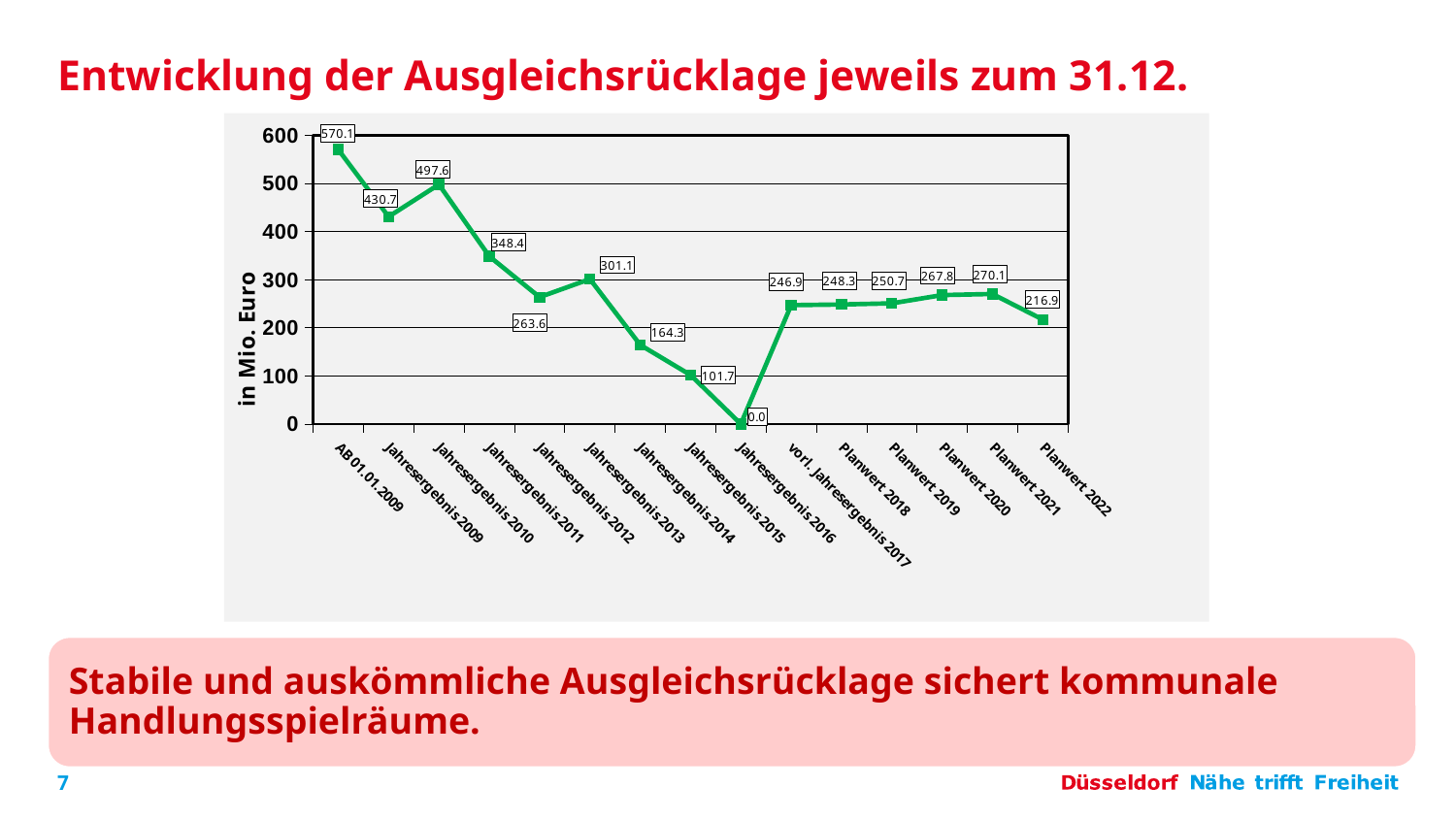
What is the value for Jahresergebnis 2011? 348.4 Which category has the highest value? AB 01.01.2009 What is the value for Planwert 2020? 267.8 What kind of chart is shown on the slide? Line chart Which is larger, the value for Jahresergebnis 2013 or the value for Jahresergebnis 2012? Jahresergebnis 2013 What is the difference between the values for Jahresergebnis 2010 and Jahresergebnis 2011? 149.2 What is the value for vorl. Jahresergebnis 2017? 246.9 What is the value for Jahresergebnis 2016? 0.0 Which category has the lowest value? Jahresergebnis 2016 How many data points are plotted on the chart? 15 Do the values rise or fall from Jahresergebnis 2013 to Jahresergebnis 2016? Fall What unit is shown on the y-axis label? in Mio. Euro